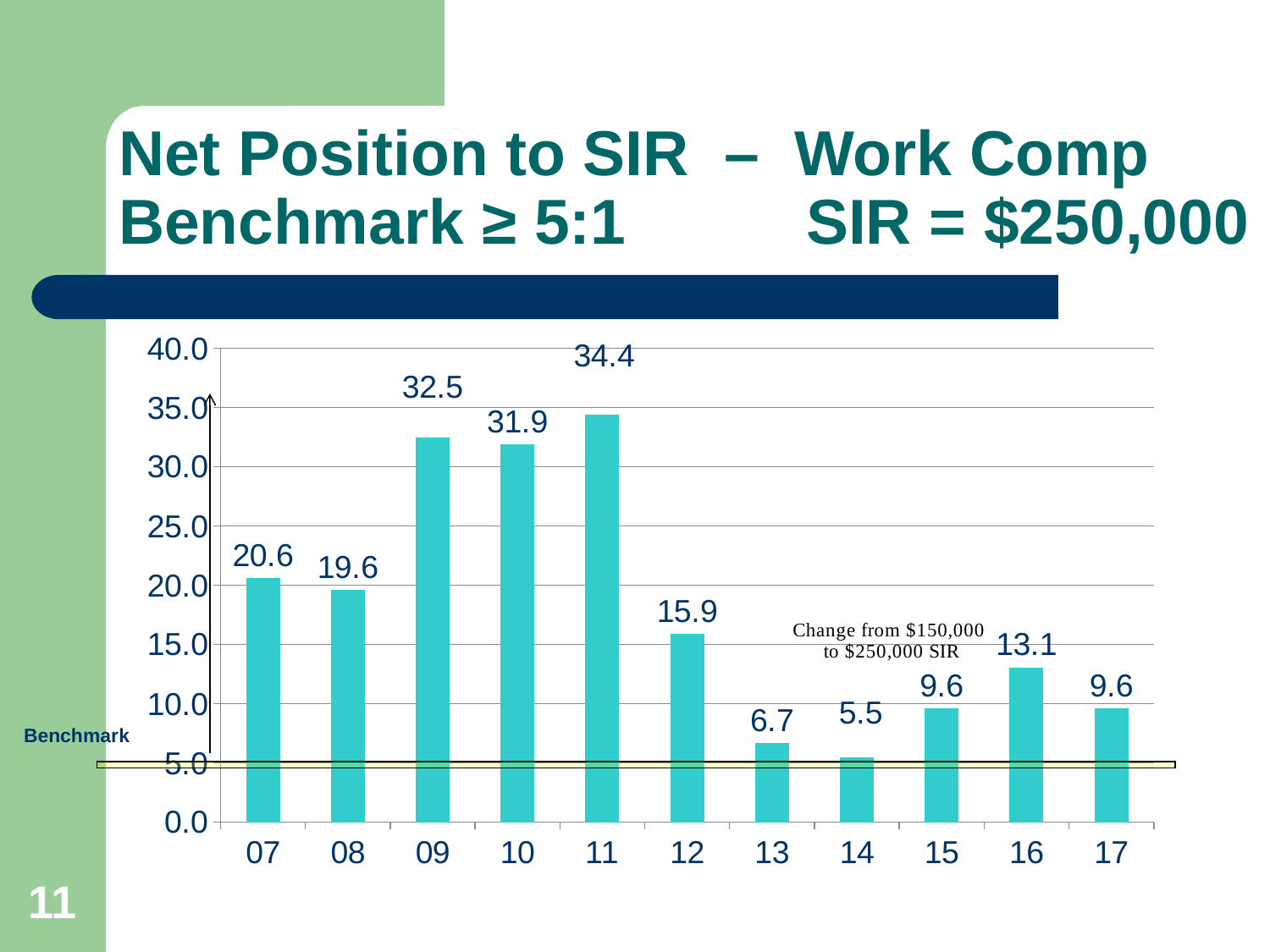
What is the value for 11? 34.4 What is the value for 07? 20.6 Is the value for 13 greater or less than 10.0? less Which is larger, the value for 08 or the value for 16? 08 What is the difference between the values for 09 and 12? 16.6 What kind of chart is this? bar chart How many years are shown on the x axis? 11 Do the values rise or fall from 11 to 14? fall Which year has the lowest value? 14 Which year has the highest value? 11 What label is shown next to the horizontal line at 5.0? Benchmark What is the value for 14? 5.5